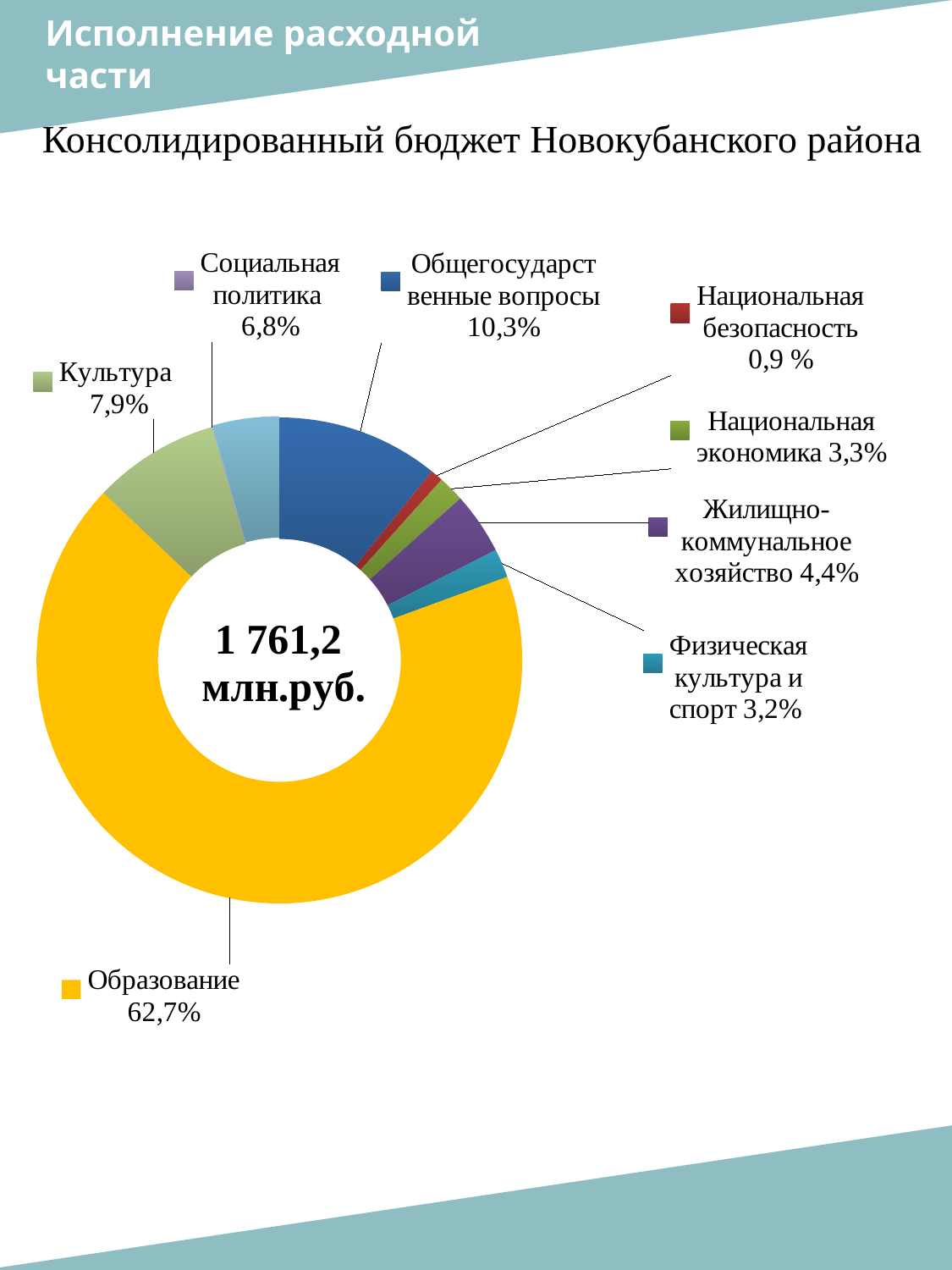
Which has a larger share, Национальная экономика or Физическая культура и спорт? Национальная экономика What kind of chart is shown on the slide? Doughnut (pie) chart What share is shown for Общегосударственные вопросы? 10,3% Which category has the smallest share of the chart? Национальная безопасность Which has a larger share, Культура or Социальная политика? Культура What share is shown for Культура? 7,9% What is the difference in percentage points between Общегосударственные вопросы and Социальная политика? 3,5 What total amount is written in the centre of the chart? 1 761,2 млн.руб. What share is shown for Жилищно-коммунальное хозяйство? 4,4% What share of the chart does Образование account for? 62,7% Which category has the largest share of the chart? Образование How many categories are shown in the chart? 8